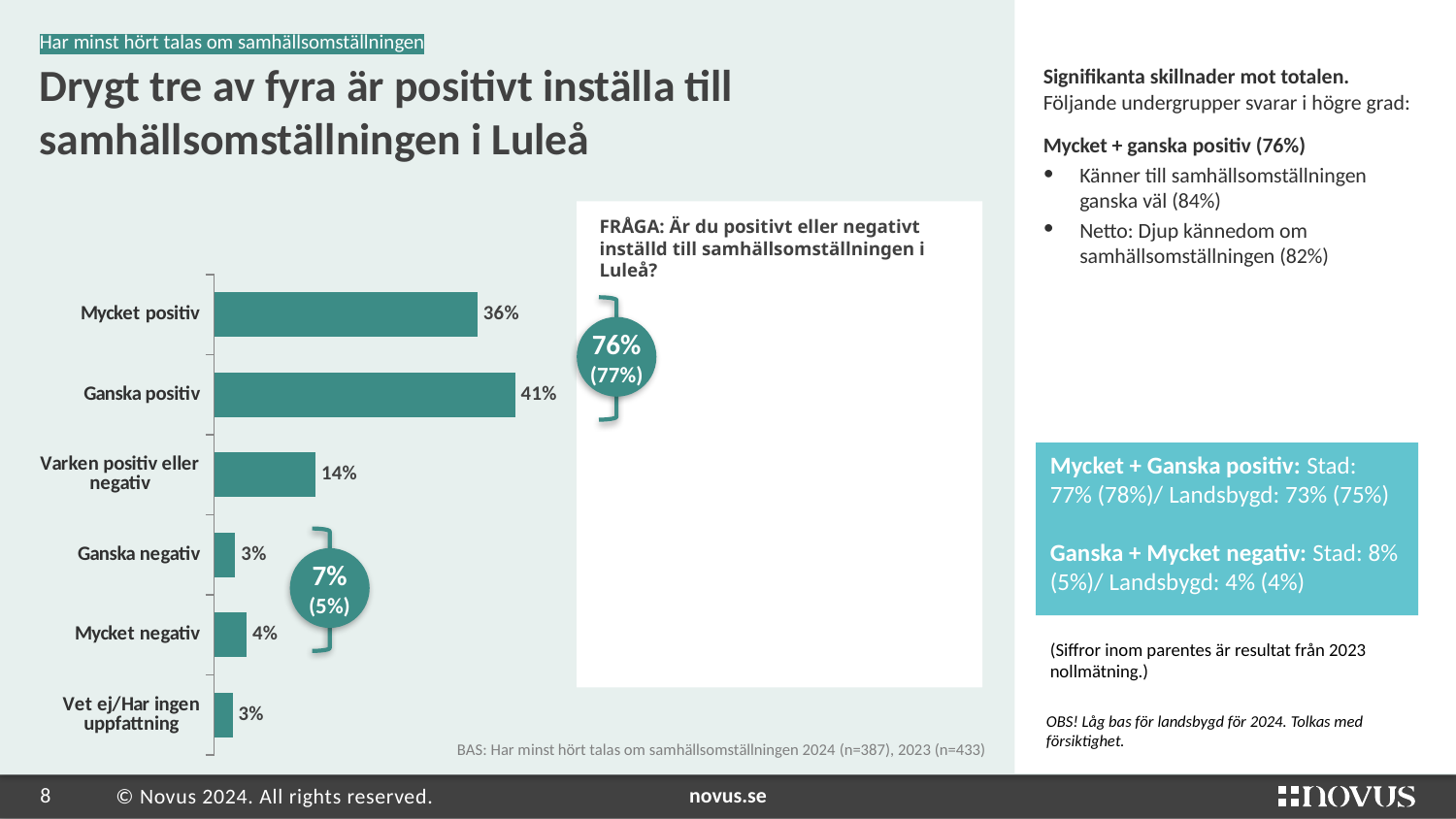
What is the value for Ganska positiv? 41% How many categories are shown in the bar chart? 6 What is the value for Mycket positiv? 36% What is the value for Vet ej/Har ingen uppfattning? 3% What is the value for Varken positiv eller negativ? 14% What kind of chart is shown on the slide? Bar chart What is the combined value of Mycket positiv and Ganska positiv? 76% Which category has the highest value? Ganska positiv What is the difference between Mycket positiv and Varken positiv eller negativ? 22% Which is larger, Mycket negativ or Ganska negativ? Mycket negativ What is the difference between Ganska positiv and Mycket positiv? 5% What is the value for Mycket negativ? 4%